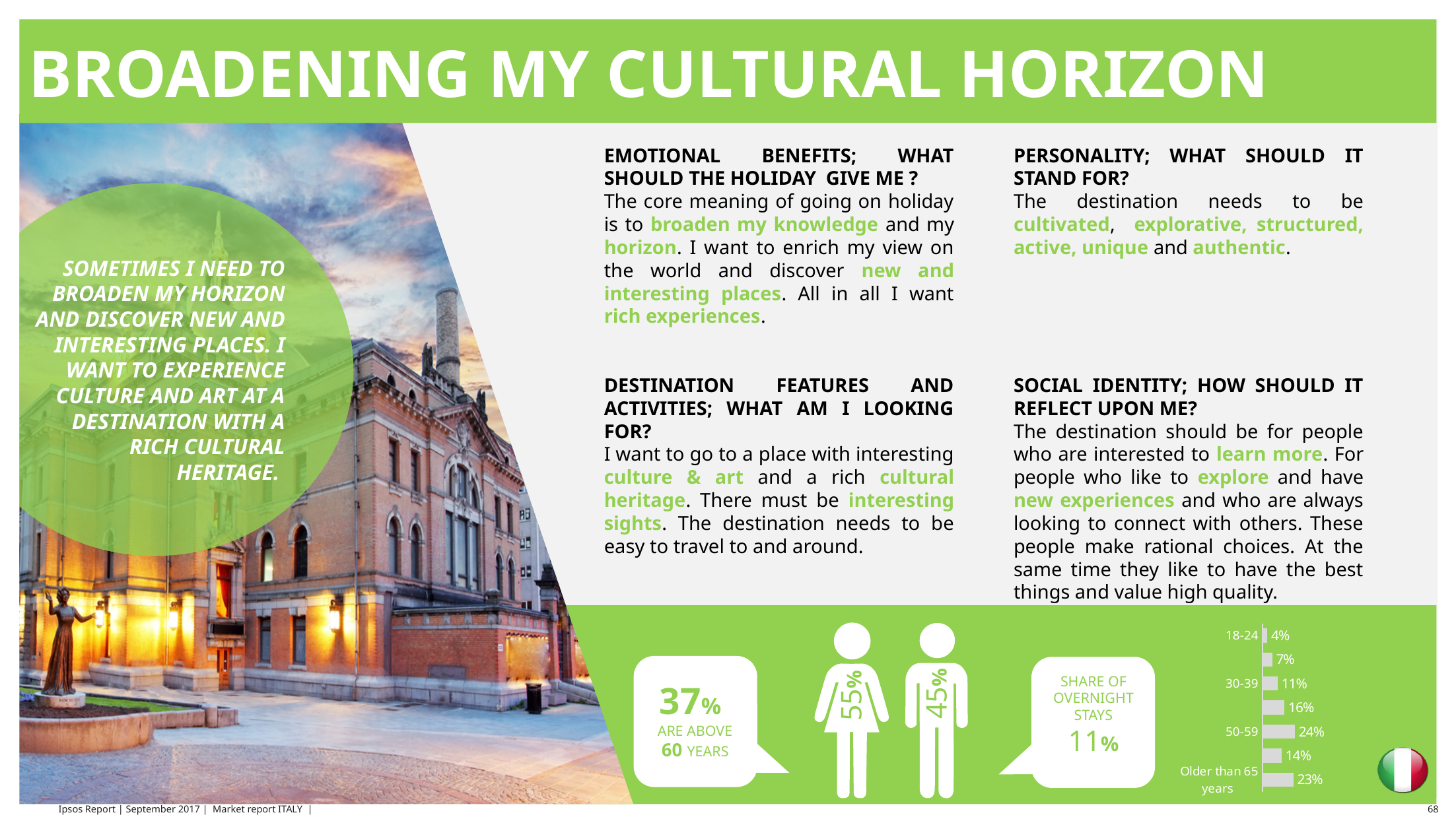
What colour are the bars in the age-group bar chart? Light grey How many bars does the age-group bar chart show? 7 In the age-group bar chart, what is the value for the 18-24 age group? 4% In the age-group bar chart, what is the difference between the values for 50-59 and 18-24? 20% In the age-group bar chart, which labelled age group has the highest value? 50-59 What kind of chart is used to show the age-group breakdown on the slide? Bar chart In the age-group bar chart, what is the value for the 'Older than 65 years' group? 23% In the age-group bar chart, what is the difference between the values for 'Older than 65 years' and 30-39? 12% In the age-group bar chart, which is larger: the value for 30-39 or the value for 'Older than 65 years'? Older than 65 years In the age-group bar chart, which age group has the lowest value? 18-24 In the age-group bar chart, what is the value for the 50-59 age group? 24% In the age-group bar chart, what is the value for the 30-39 age group? 11%